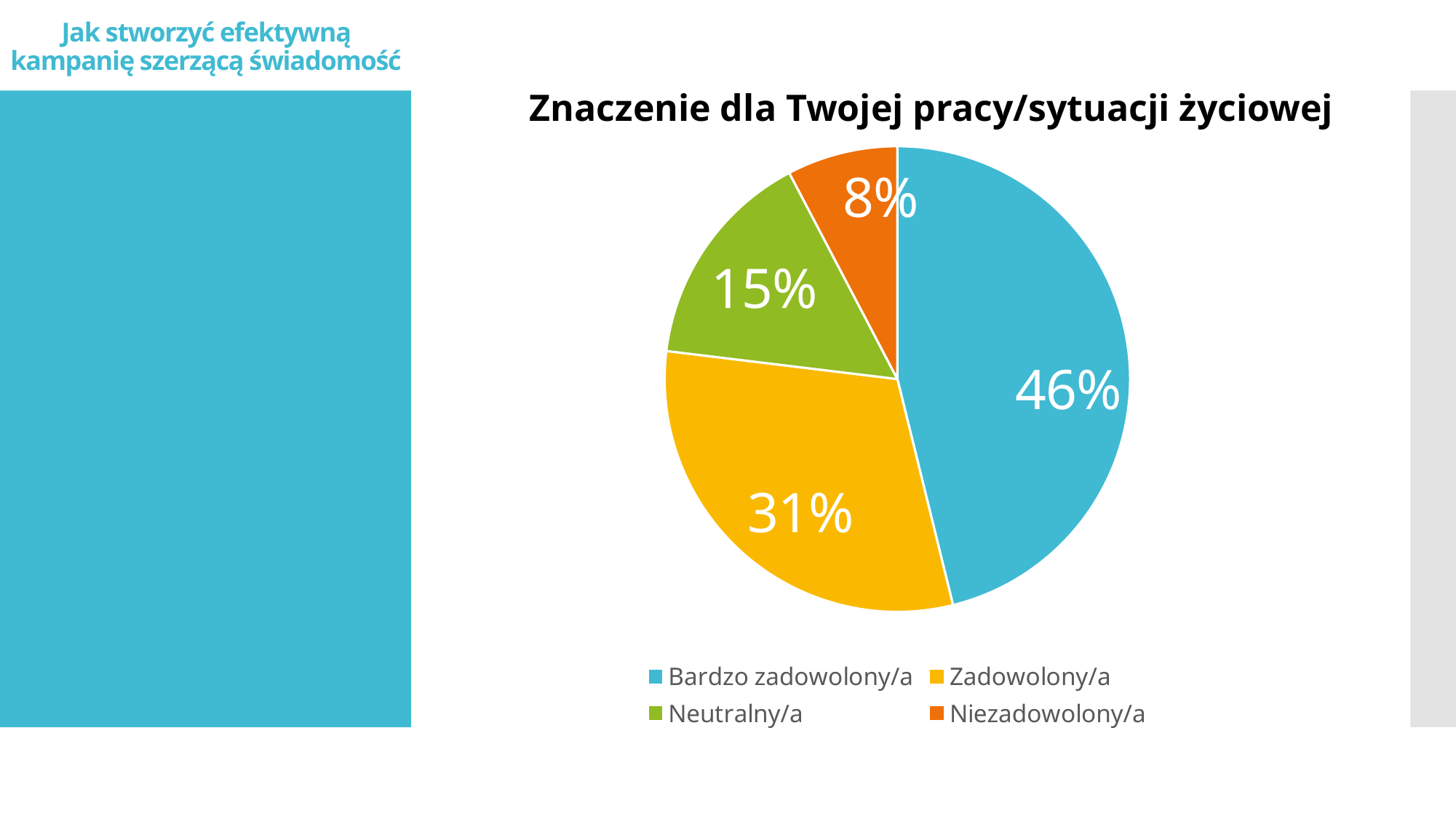
What is the title of the chart? Znaczenie dla Twojej pracy/sytuacji życiowej How many categories does the pie chart show? 4 What is the value for Niezadowolony/a? 8% Which is larger, Neutralny/a or Niezadowolony/a? Neutralny/a Which category has the largest slice? Bardzo zadowolony/a What is the value for Zadowolony/a? 31% Which category has the smallest slice? Niezadowolony/a Which colour represents Zadowolony/a in the chart? Yellow What share of the pie does Bardzo zadowolony/a have? 46% What is the value for Neutralny/a? 15% What is the difference between Bardzo zadowolony/a and Zadowolony/a? 15% What kind of chart is shown on the slide? Pie chart